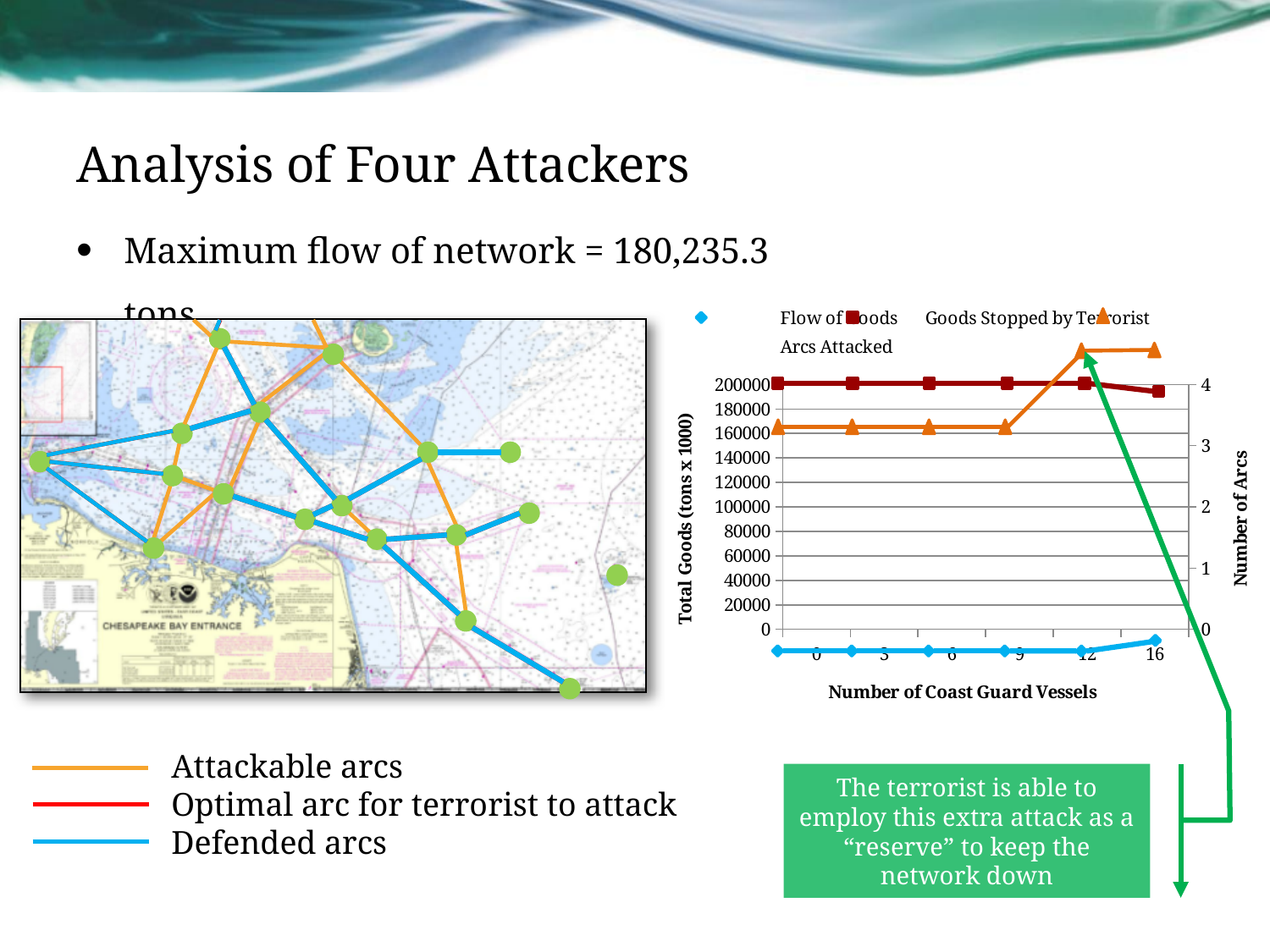
How many values of Number of Coast Guard Vessels are labelled on the x axis of the chart? 6 What is the title of the x axis of the chart? Number of Coast Guard Vessels Is the value of Arcs Attacked at 3 Coast Guard Vessels greater or less than 2 on the Number of Arcs axis? greater Is the value of Goods Stopped by Terrorist at 0 Coast Guard Vessels greater or less than 100000? greater At which Number of Coast Guard Vessels is Goods Stopped by Terrorist lowest? 16 At 0 Coast Guard Vessels, which is larger: Goods Stopped by Terrorist or Flow of Goods? Goods Stopped by Terrorist What is the title of the left y axis of the chart? Total Goods (tons x 1000) How many series does the legend of the chart list? 3 What kind of chart is shown on the right side of the slide? line chart Does the Arcs Attacked series rise or fall between 9 and 12 Coast Guard Vessels? rise